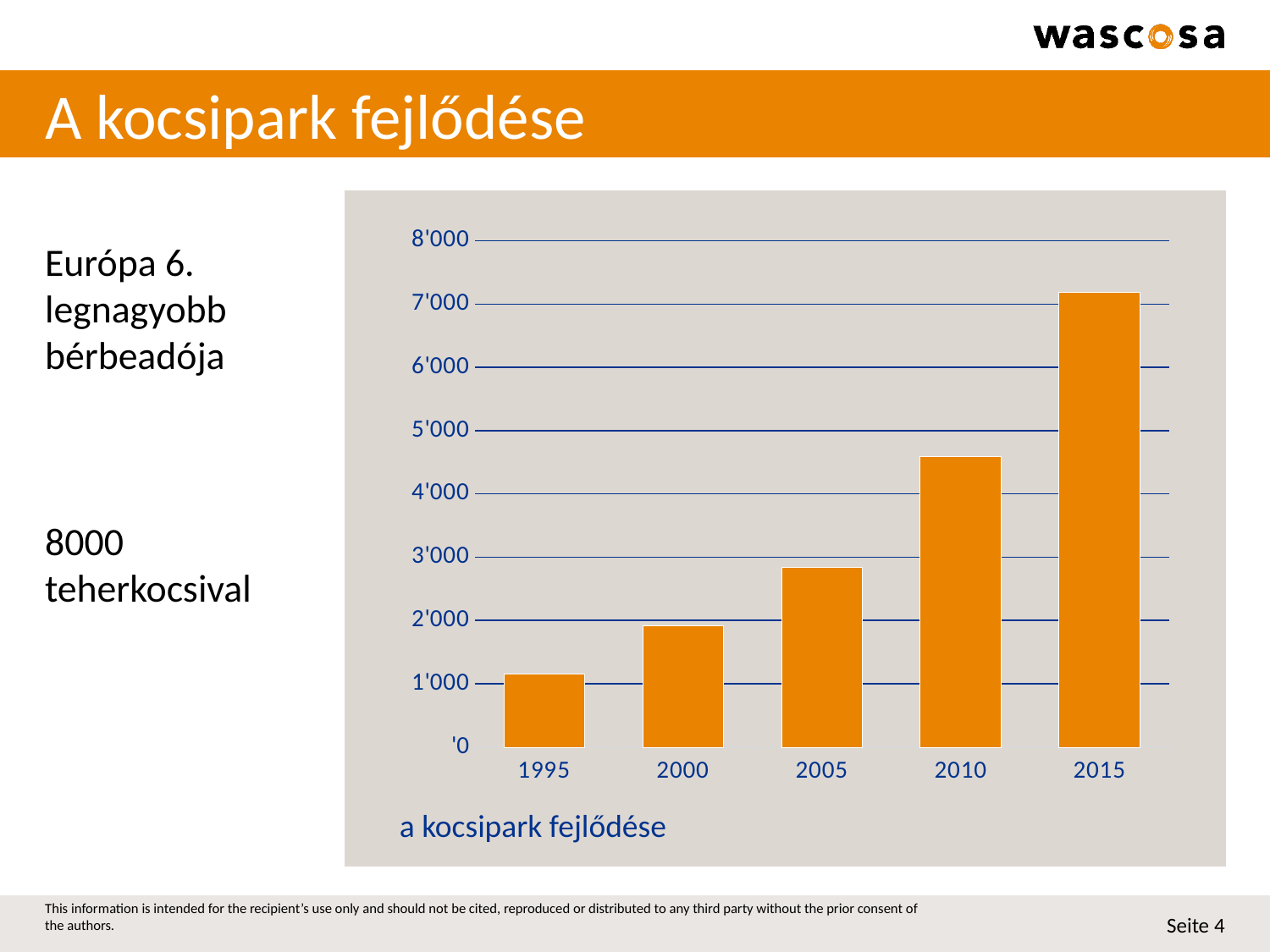
Which year has the highest bar in the chart? 2015 Is the value for 2015 greater or less than 7'000? greater Is the value for 2005 greater or less than 3'000? less Which year has the lowest bar in the chart? 1995 What is the title shown below the chart? a kocsipark fejlődése Which is larger, the value for 2010 or the value for 2005? 2010 How many bars (years) are plotted in the chart? 5 What kind of chart is shown on the slide? bar chart What colour are the bars in the chart? orange Is the value for 2010 greater or less than 4'000? greater Do the values rise or fall from 1995 to 2015? rise